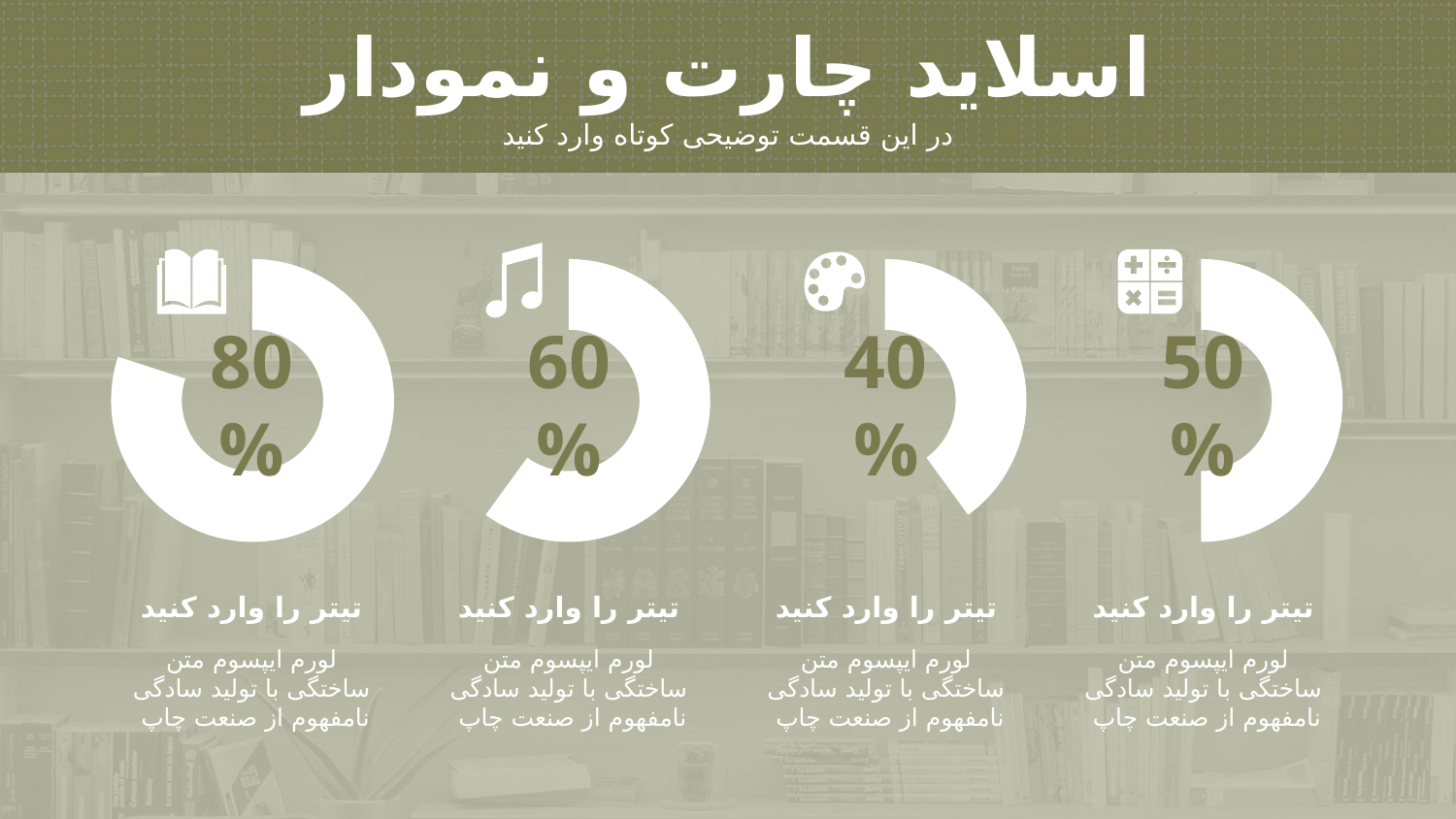
What value is shown in the leftmost donut chart (with the book icon)? 80% What is the difference between the values in the second and third donut charts from the left? 20% What value is shown in the third donut chart from the left (with the palette icon)? 40% What icon appears above the donut chart showing 60%? A music note Which of the four donut charts shows the lowest percentage? The third chart from the left (palette icon), 40% What value is shown in the rightmost donut chart (with the calculator icon)? 50% What kind of chart is used to display the percentages on this slide? Donut chart How many donut charts are shown on the slide? 4 What is the difference between the value in the leftmost donut chart and the value in the rightmost donut chart? 30% What value is shown in the second donut chart from the left (with the music note icon)? 60% Which of the four donut charts shows the highest percentage? The leftmost chart (book icon), 80% Which is larger: the value in the second donut chart from the left or the value in the rightmost donut chart? The second chart from the left (60%)